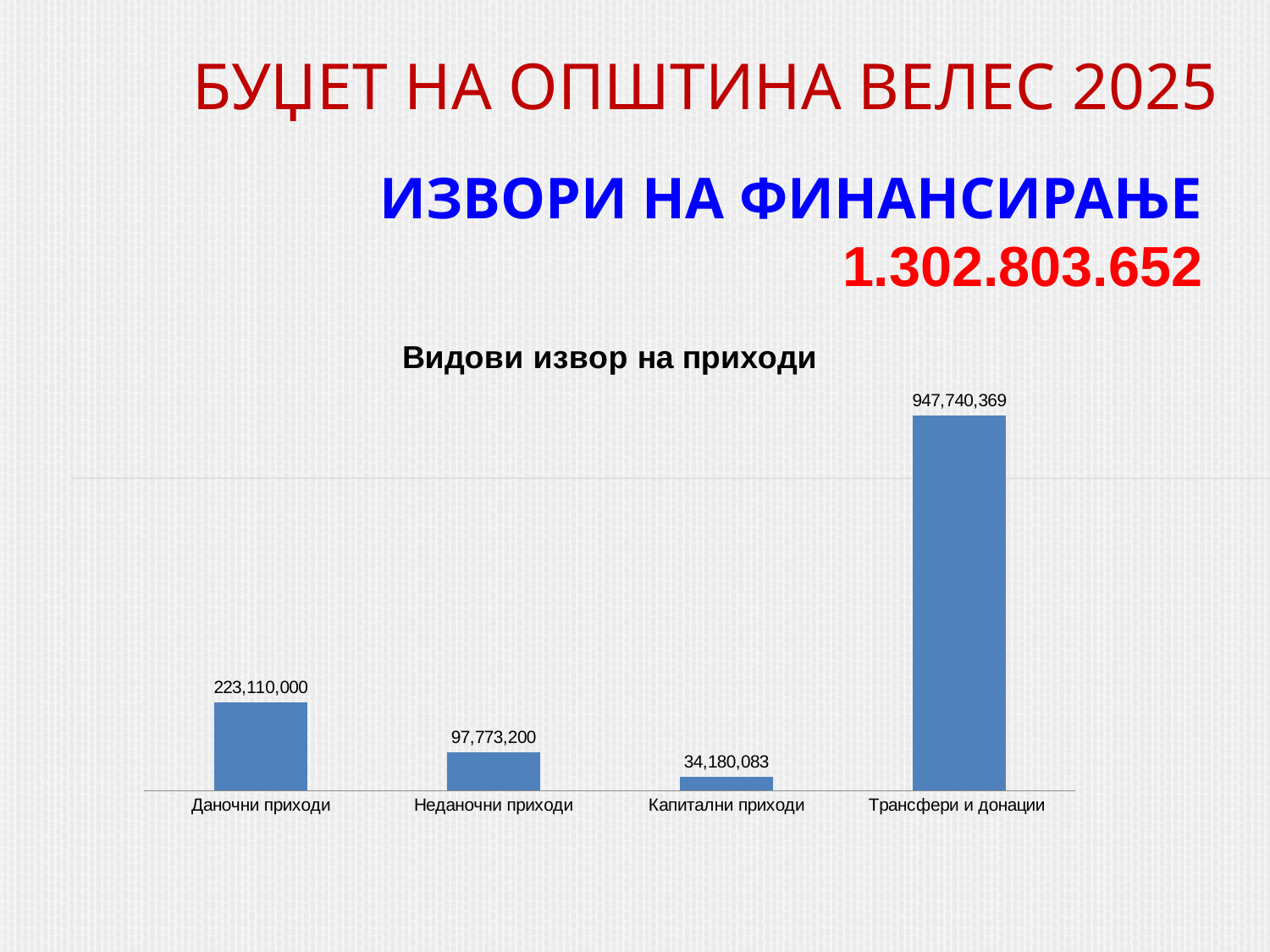
What is the value for Капитални приходи? 34,180,083 What is the value for Даночни приходи? 223,110,000 Which is larger, Даночни приходи or Неданочни приходи? Даночни приходи Which category has the lowest value? Капитални приходи What is the value for Неданочни приходи? 97,773,200 What is the difference between Трансфери и донации and Даночни приходи? 724,630,369 Which category has the highest value? Трансфери и донации How many categories are shown in the chart? 4 What is the title of the chart? Видови извор на приходи What kind of chart is shown on the slide? bar chart What is the difference between Даночни приходи and Неданочни приходи? 125,336,800 What is the value for Трансфери и донации? 947,740,369